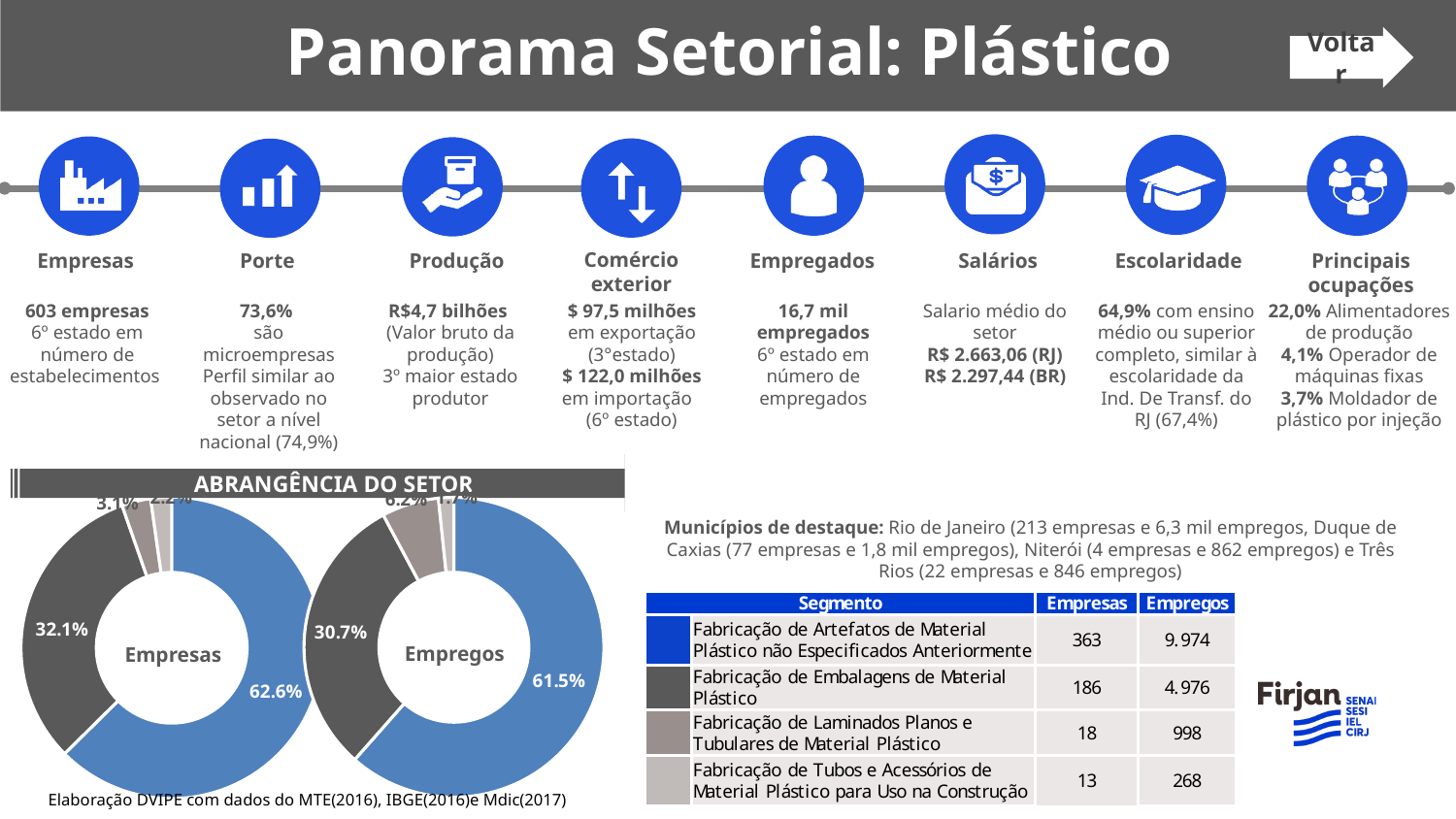
In the 'Empresas' chart, what is the difference in percentage points between the Artefatos slice (62.6%) and the Embalagens slice (32.1%)? 30.5 percentage points In the 'Empregos' chart, what share does the largest slice (Fabricação de Artefatos de Material Plástico não Especificados Anteriormente) have? 61.5% In the 'Empresas' chart, what share does the largest slice (Fabricação de Artefatos de Material Plástico não Especificados Anteriormente) have? 62.6% In the 'Empregos' chart, what is the difference in percentage points between the Artefatos slice (61.5%) and the Embalagens slice (30.7%)? 30.8 percentage points In the 'Empresas' chart, what share does the Fabricação de Embalagens de Material Plástico slice have? 32.1% In the 'Empregos' chart, is the share for Fabricação de Embalagens de Material Plástico greater or less than 50%? less In the 'Empregos' chart, what share does the Fabricação de Embalagens de Material Plástico slice have? 30.7% In the 'Empresas' chart, which segment has the largest share? Fabricação de Artefatos de Material Plástico não Especificados Anteriormente Which chart shows a larger share for Fabricação de Artefatos de Material Plástico não Especificados Anteriormente, 'Empresas' or 'Empregos'? Empresas How many slices does the 'Empresas' chart have? 4 What kind of chart is used for the 'Empresas' and 'Empregos' charts under 'Abrangência do Setor'? doughnut chart Which colour represents Fabricação de Artefatos de Material Plástico não Especificados Anteriormente in the charts? blue